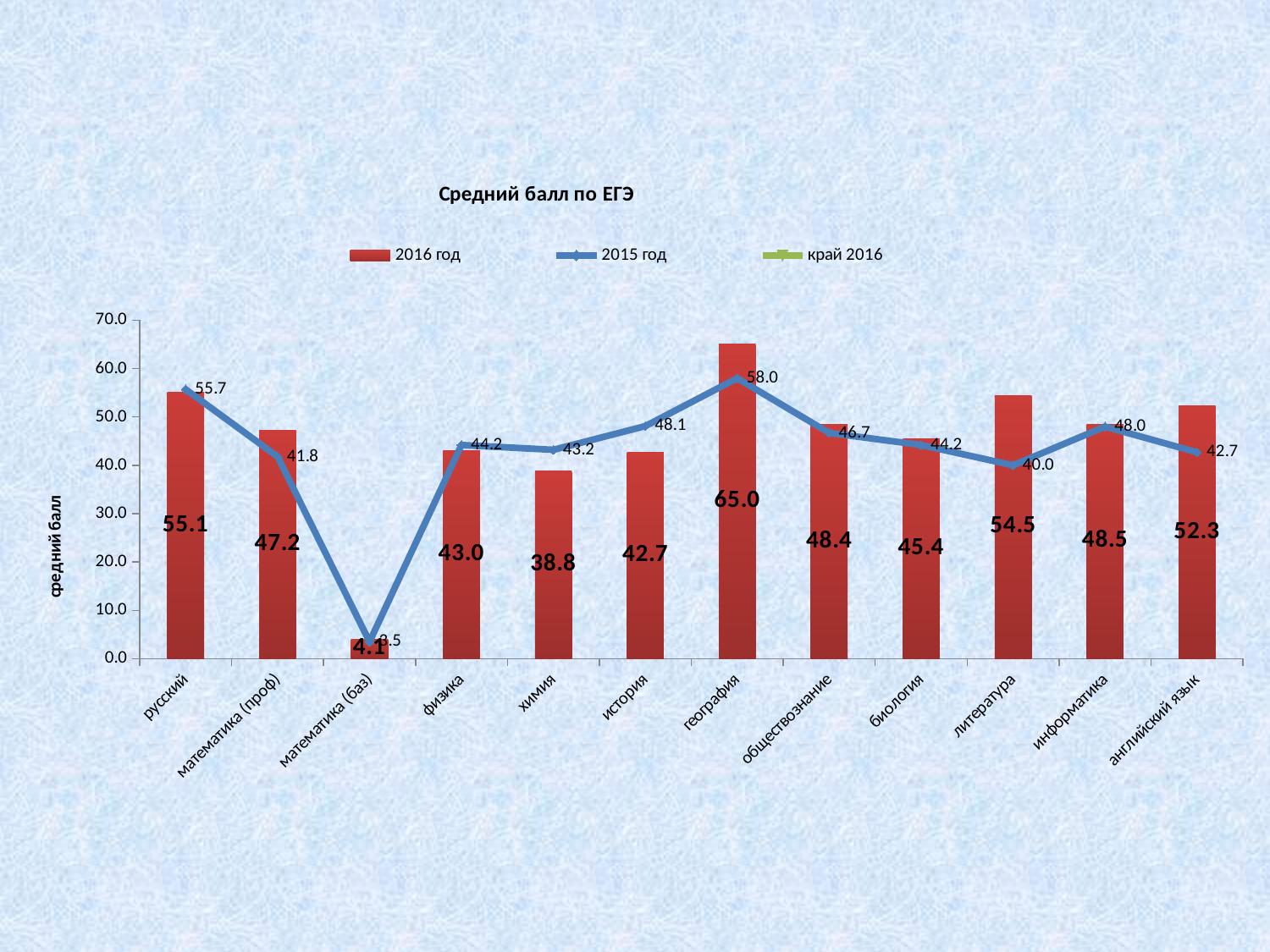
What is the 2016 год value for география? 65.0 Which subject has the lowest 2016 год value? математика (баз) How many subjects are shown on the x axis? 12 Which is larger for физика: the 2016 год value or the 2015 год value? 2015 год What is the title of the chart? Средний балл по ЕГЭ What type of chart is shown on the slide? Combined bar and line chart What is the 2015 год value for история? 48.1 What is the difference between the 2016 год and 2015 год values for литература? 14.5 What is the 2015 год value for английский язык? 42.7 What is the 2016 год value for химия? 38.8 Which subject has the highest 2016 год value? география How many series does the legend list? 3